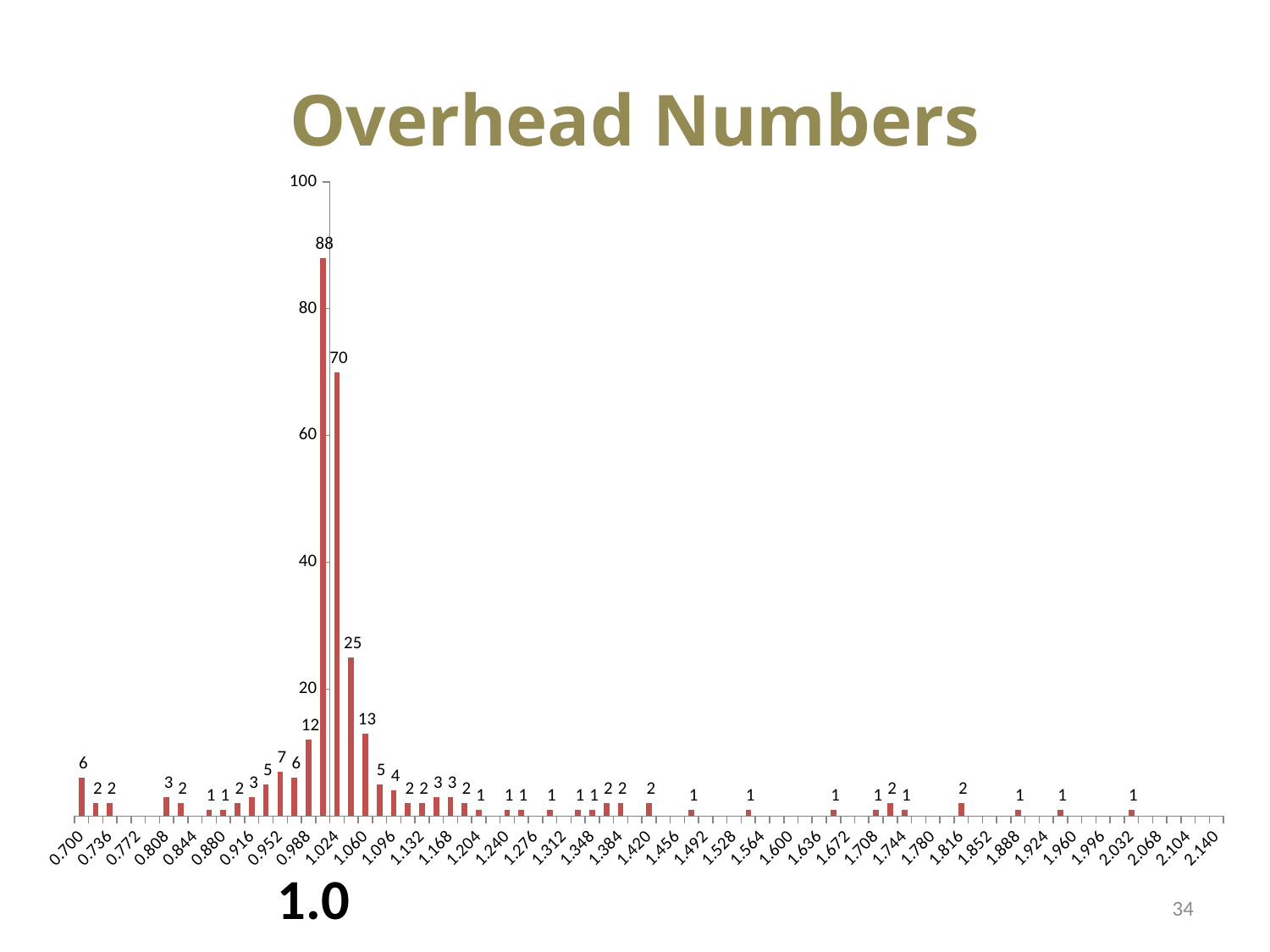
What is the value of the bar at 0.700? 6 What is the maximum value shown on the vertical axis? 100 What is the highest value labelled on any bar in the chart? 88 What is the smallest value labelled on any bar in the chart? 1 What is the difference between the two tallest bars, labelled 88 and 70? 18 Is the value of the tallest bar greater or less than 80? greater What is the second-highest value labelled on a bar in the chart? 70 What kind of chart is shown on the slide? bar chart Is the value of the bar at 0.700 greater or less than 20? less Which is larger, the bar labelled 25 or the bar labelled 13? 25 What is the difference between the bars labelled 25 and 13? 12 What is the title of the chart? Overhead Numbers